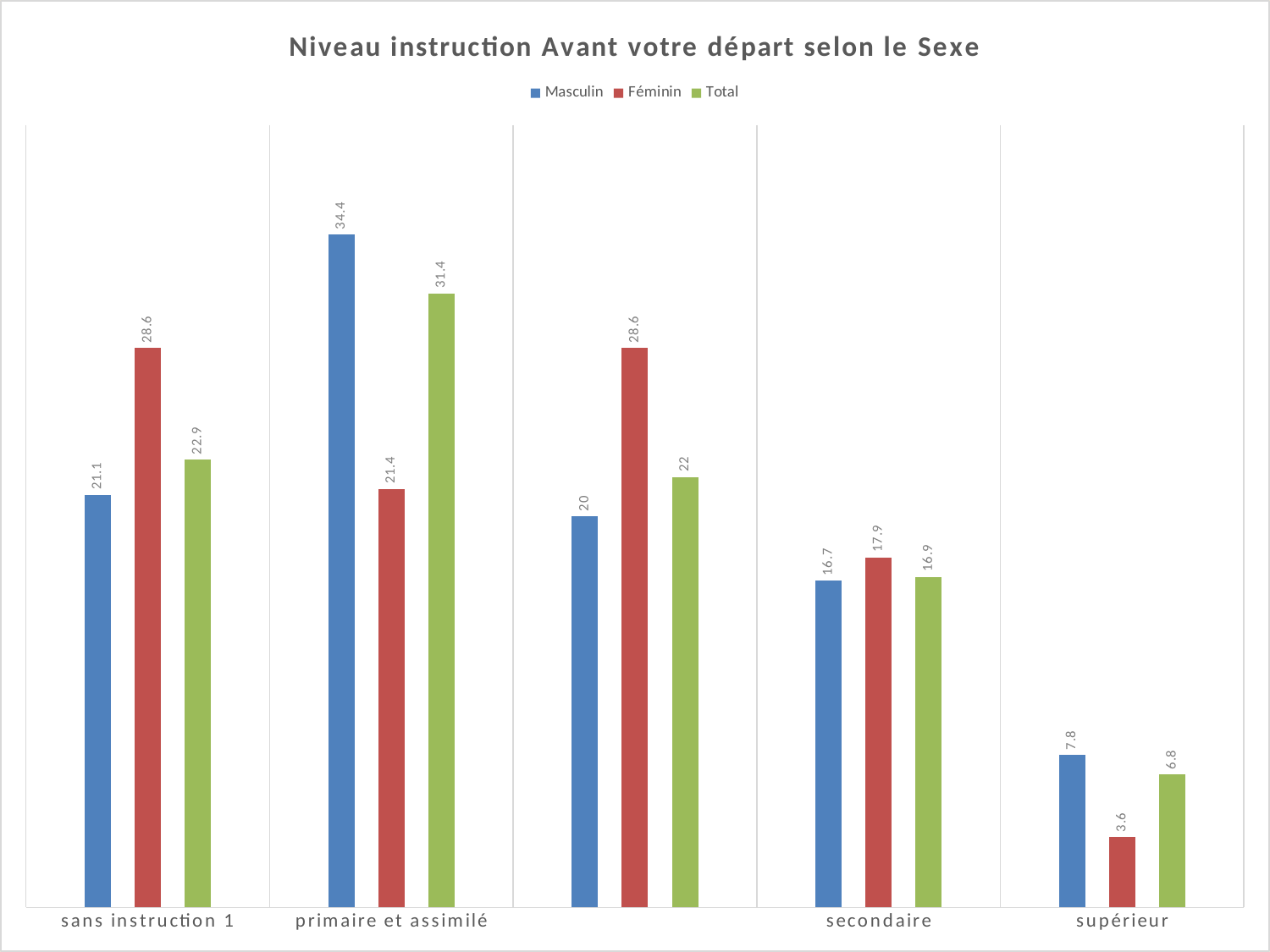
How many series does the legend list? 3 Which category has the lowest Total value? supérieur What kind of chart is shown on the slide? bar chart What is the Féminin value for supérieur? 3.6 Which category has the highest Masculin value? primaire et assimilé How many category groups are plotted on the chart? 5 What is the difference between the Masculin and Féminin values for primaire et assimilé? 13 What is the Total value for secondaire? 16.9 What is the Masculin value for primaire et assimilé? 34.4 What is the title of the chart? Niveau instruction Avant votre départ selon le Sexe What is the Féminin value for sans instruction 1? 28.6 For sans instruction 1, which is larger: the Masculin value or the Féminin value? Féminin